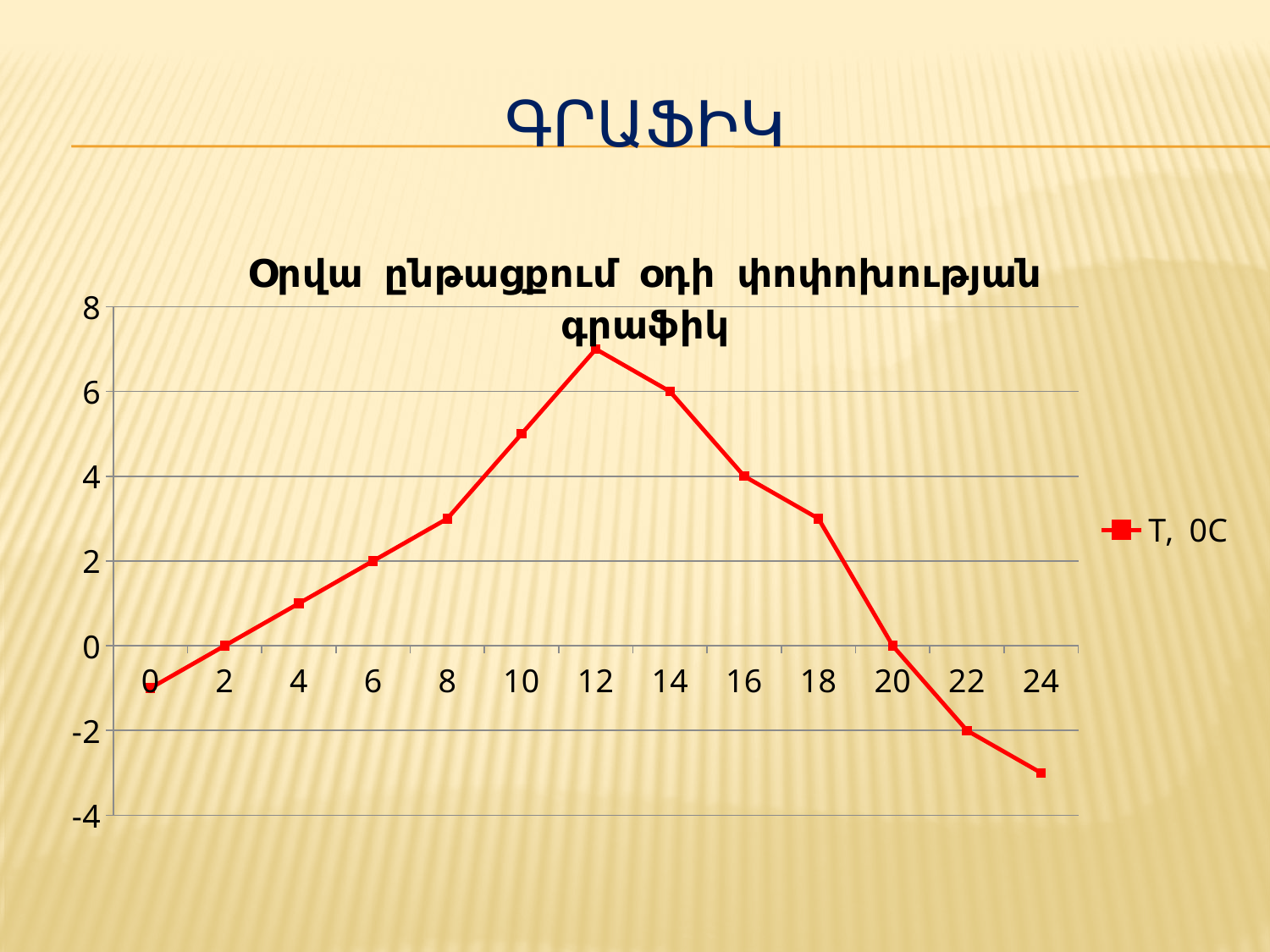
Is the value at x = 12 greater or less than 6? greater How many series does the legend list? 1 At which x-axis value is the temperature highest? 12 Is the value at x = 24 greater or less than -2? less What is the value at x = 22? -2 What is the value at x = 16? 4 At which x-axis value is the temperature lowest? 24 What kind of chart is shown on the slide? line chart How many data points are plotted on the line? 13 What is the difference between the values at x = 14 and x = 16? 2 What is the value at x = 14? 6 What is the legend entry for the plotted series? T, 0C